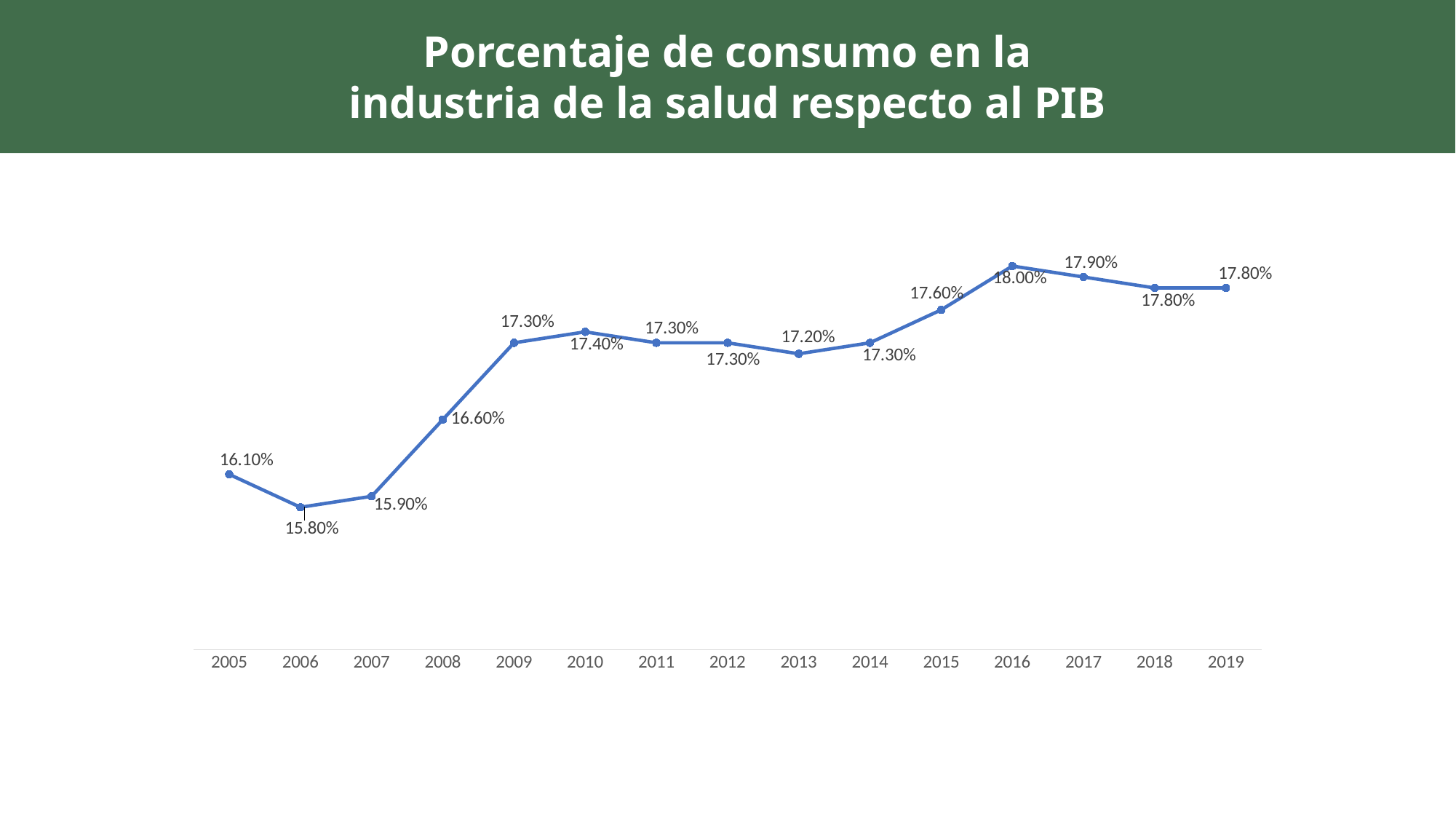
What is the value for 2019? 17.80% What is the difference between the values for 2009 and 2008? 0.70% What is the value for 2016? 18.00% What is the value for 2008? 16.60% What is the difference between the values for 2016 and 2006? 2.20% What kind of chart is shown on the slide? Line chart How many years are plotted on the chart? 15 Do the values rise or fall from 2005 to 2019 overall? Rise Which year has the lowest value? 2006 Which year has the highest value? 2016 What is the value for 2005? 16.10% Which is larger, the value for 2015 or the value for 2014? 2015